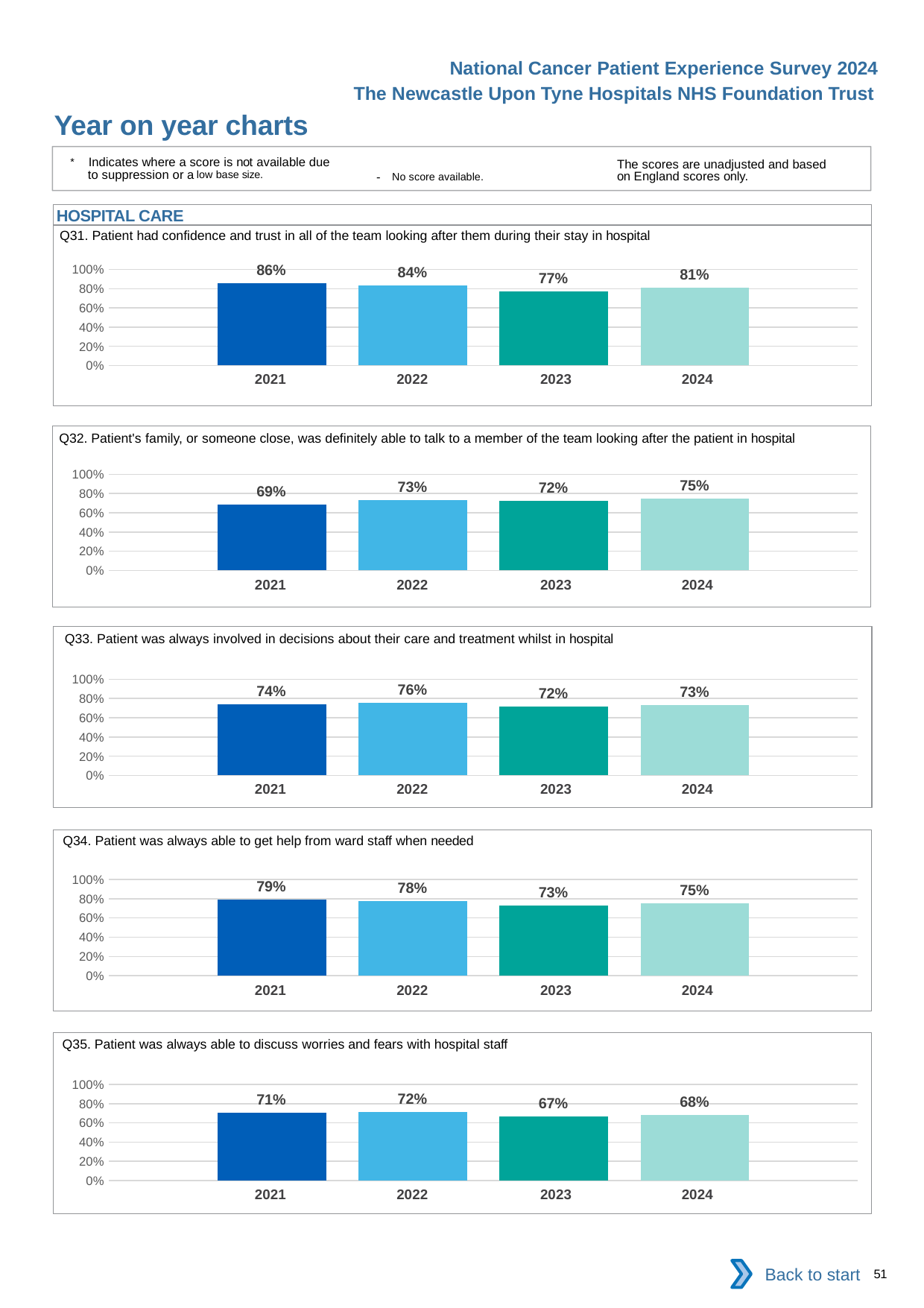
In the Q32 chart (family able to talk to a member of the team), what is the difference between the 2024 and 2021 values? 6 percentage points In the Q33 chart (involved in decisions about care), what is the value for 2023? 72% In the Q34 chart (able to get help from ward staff), what is the difference between the 2021 and 2023 values? 6 percentage points In the Q34 chart (able to get help from ward staff), is the value for 2021 larger or smaller than the value for 2023? larger In the Q32 chart (family able to talk to a member of the team), what is the value for 2024? 75% In the Q31 chart (confidence and trust in the team), which year has the lowest value? 2023 What kind of chart is used for Q34 (able to get help from ward staff)? Bar chart In the Q35 chart (discuss worries and fears with hospital staff), what is the value for 2024? 68% In the Q35 chart (discuss worries and fears with hospital staff), which year has the lowest value? 2023 How many years are shown on the x axis of the Q31 chart? 4 In the Q33 chart (involved in decisions about care), which year has the highest value? 2022 In the Q31 chart (confidence and trust in the team), what is the value for 2021? 86%